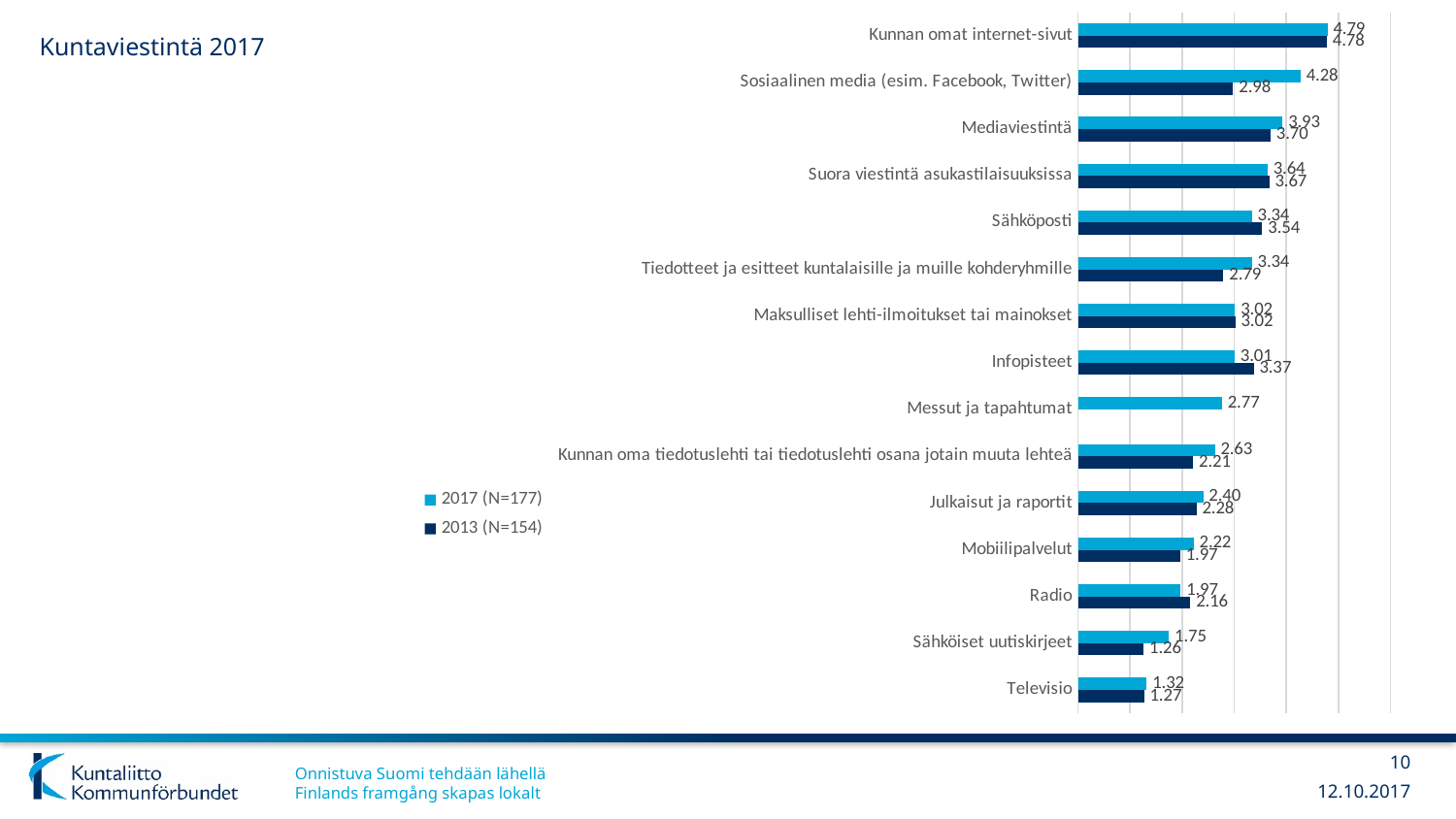
What is the 2017 (N=177) value for Sosiaalinen media (esim. Facebook, Twitter)? 4.28 What is the title of the slide containing the chart? Kuntaviestintä 2017 What is the 2013 (N=154) value for Sähköposti? 3.54 Which category has the highest 2017 (N=177) value? Kunnan omat internet-sivut What is the difference between the 2017 (N=177) and 2013 (N=154) values for Sosiaalinen media (esim. Facebook, Twitter)? 1.30 Which category has the lowest 2013 (N=154) value? Sähköiset uutiskirjeet What is the 2017 (N=177) value for Messut ja tapahtumat? 2.77 How many categories are shown on the chart? 15 What kind of chart is shown on the slide? Bar chart What is the 2013 (N=154) value for Televisio? 1.27 How many series does the legend list? 2 For Infopisteet, which is larger: the 2017 (N=177) value or the 2013 (N=154) value? 2013 (N=154)